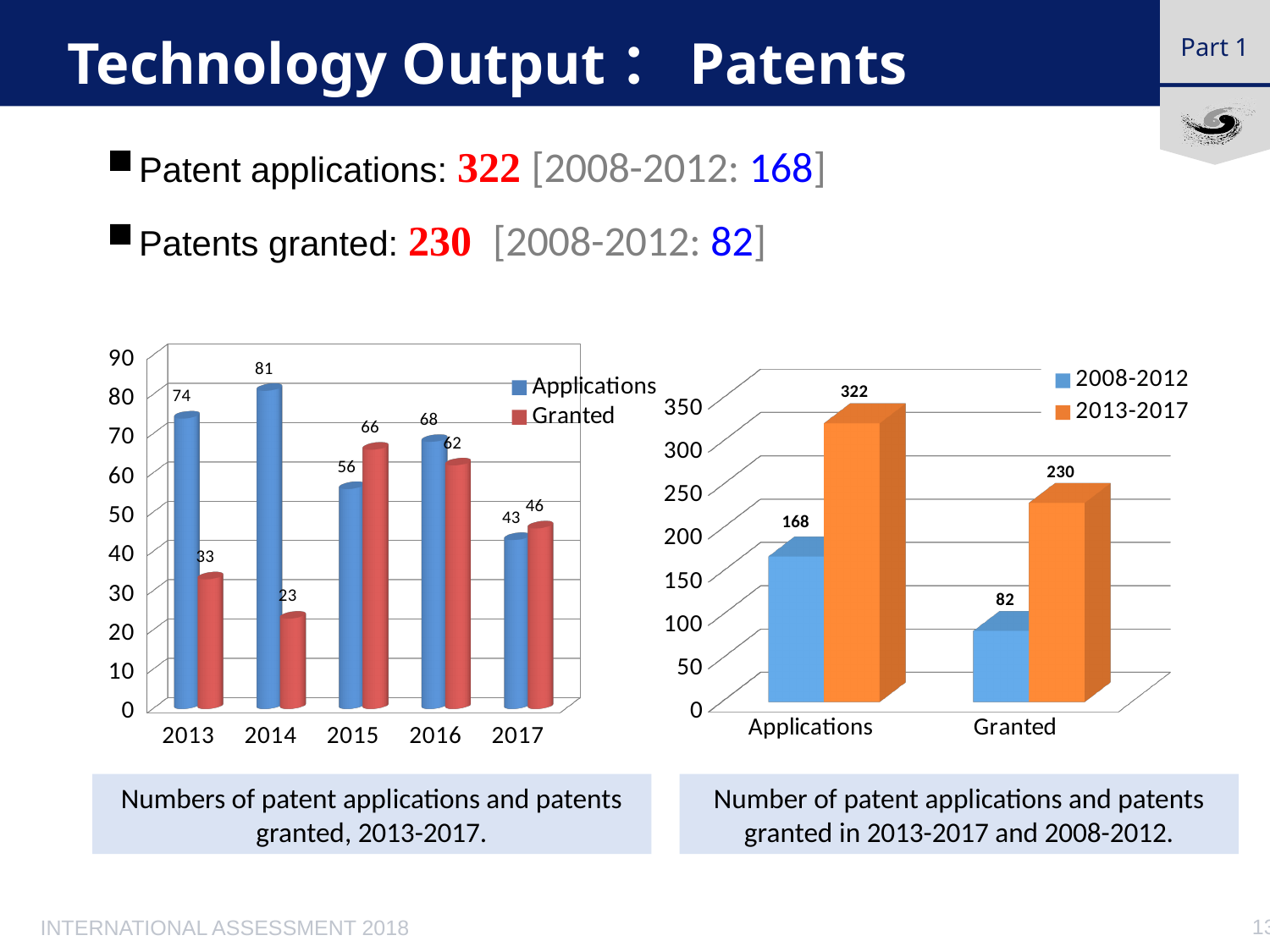
In the right chart, what is the difference between Granted in 2013-2017 and Granted in 2008-2012? 148 How many years are shown on the x axis of the left chart? 5 What kind of chart is the right chart? bar chart In the left chart, what is the difference between Applications and Granted in 2013? 41 In the right chart, what is the value for Applications in 2013-2017? 322 In the left chart, what is the value for Applications in 2014? 81 In the left chart, which is larger in 2017, Applications or Granted? Granted In the left chart, what is the value for Granted in 2015? 66 How many series does the legend of the right chart list? 2 In the left chart, do the Applications values rise or fall from 2014 to 2017? fall In the left chart, which year has the lowest number of patents Granted? 2014 In the left chart, which year has the highest number of Applications? 2014